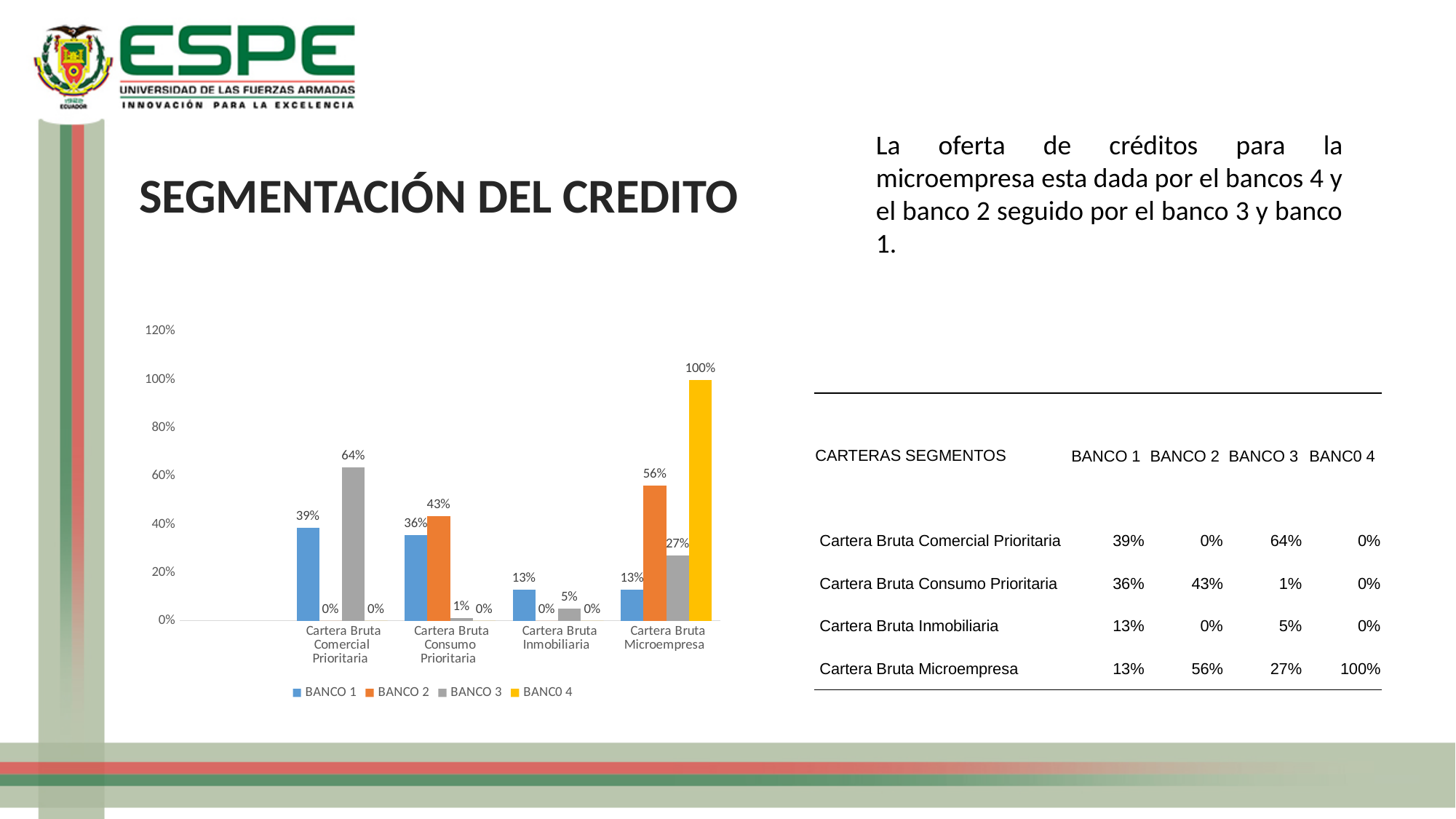
What kind of chart is shown on the slide? Bar chart How many series does the chart legend list? 4 What is the difference between BANCO 2 and BANCO 1 in the Cartera Bruta Consumo Prioritaria category? 7% Which colour represents BANC0 4 in the chart? Yellow What is the value for BANCO 1 in the Cartera Bruta Consumo Prioritaria category? 36% What is the value for BANCO 2 in the Cartera Bruta Microempresa category? 56% What is the value for BANCO 3 in the Cartera Bruta Comercial Prioritaria category? 64% Which is larger in the Cartera Bruta Microempresa category: BANCO 2 or BANCO 3? BANCO 2 How many categories are shown on the x axis of the chart? 4 Is the value for BANCO 3 in Cartera Bruta Comercial Prioritaria greater or less than 60%? greater Which bank has the highest value in the Cartera Bruta Microempresa category? BANC0 4 Which bank has the lowest value in the Cartera Bruta Consumo Prioritaria category? BANC0 4